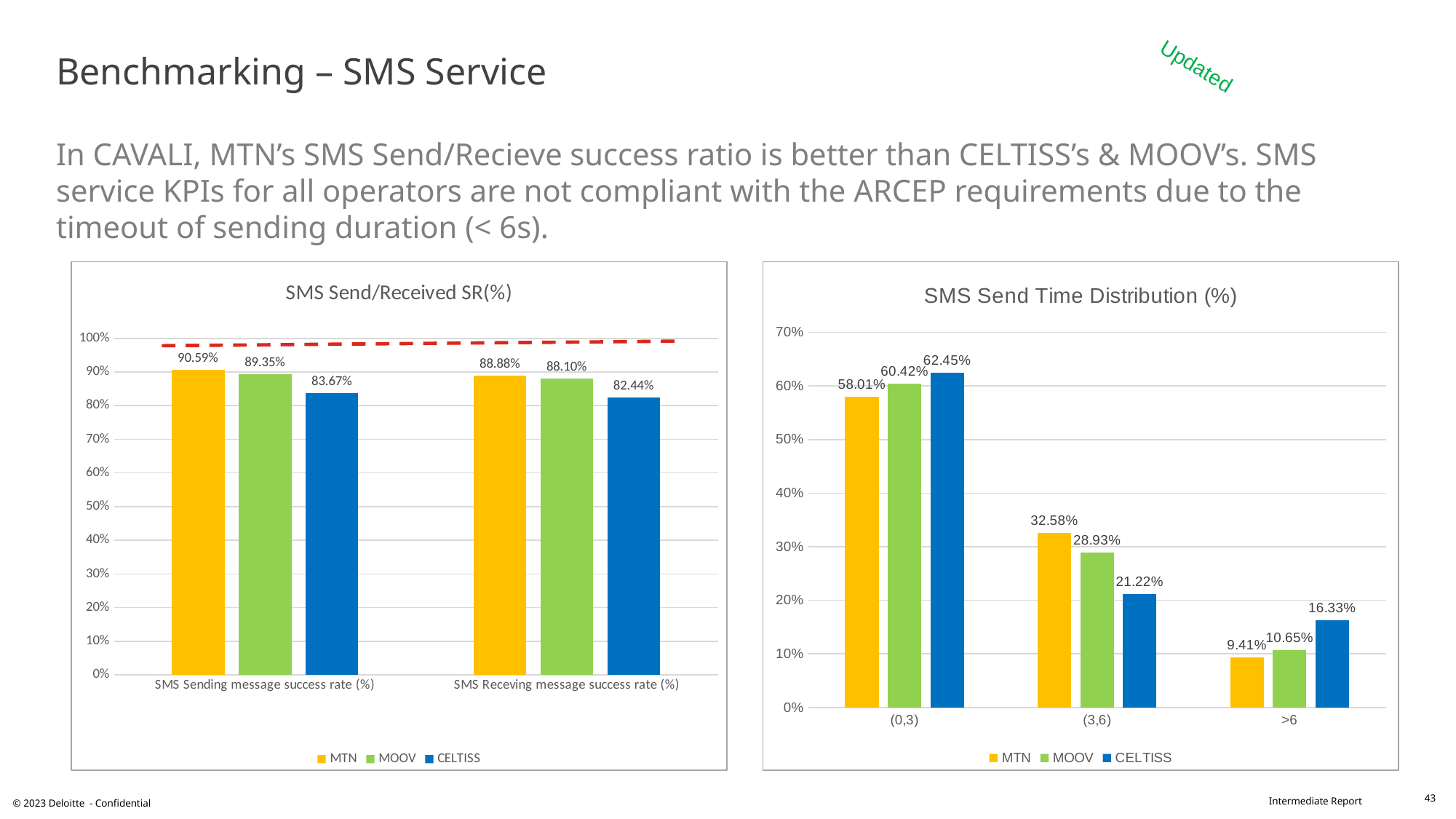
In the 'SMS Send/Received SR(%)' chart, what is the difference between MTN and MOOV for SMS Receving message success rate (%)? 0.78% In the 'SMS Send Time Distribution (%)' chart, what is the difference between MTN and CELTISS in the (3,6) category? 11.36% What kind of chart is the 'SMS Send Time Distribution (%)' chart? bar chart In the 'SMS Send Time Distribution (%)' chart, how many categories are shown on the x axis? 3 In the 'SMS Send Time Distribution (%)' chart, which operator has the highest value in the (0,3) category? CELTISS In the 'SMS Send/Received SR(%)' chart, what is the value for CELTISS for SMS Receving message success rate (%)? 82.44% In the 'SMS Send/Received SR(%)' chart, how many series does the legend list? 3 In the 'SMS Send Time Distribution (%)' chart, what is the value for MOOV in the (3,6) category? 28.93% In the 'SMS Send/Received SR(%)' chart, which operator has the lowest SMS Sending message success rate (%)? CELTISS In the 'SMS Send/Received SR(%)' chart, what is the value for MTN for SMS Sending message success rate (%)? 90.59% In the 'SMS Send Time Distribution (%)' chart, is the value for MTN in the (3,6) category larger or smaller than the value for MOOV in the same category? larger In the 'SMS Send Time Distribution (%)' chart, what is the value for CELTISS in the >6 category? 16.33%